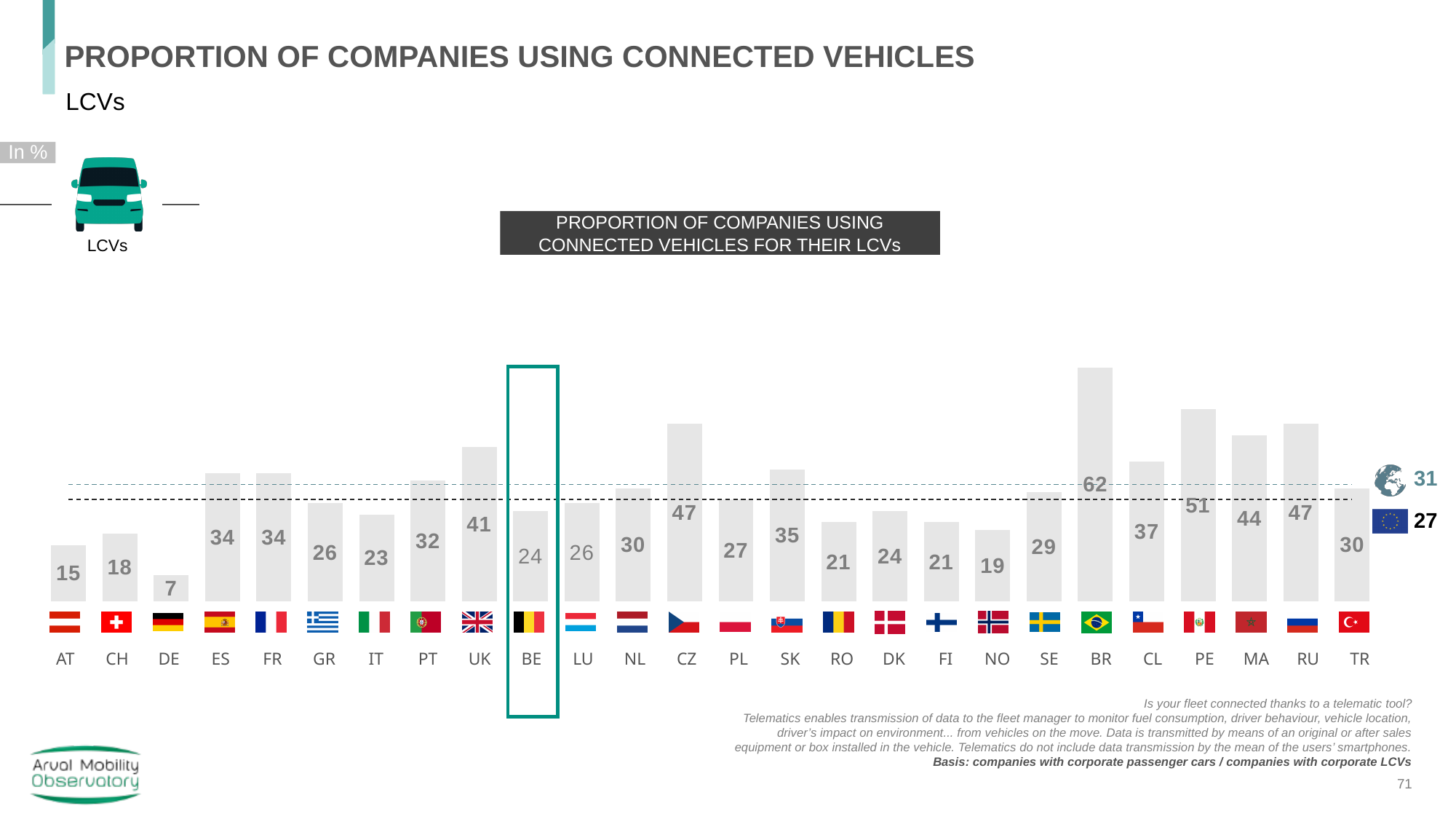
What is the value for BR (Brazil) in the chart? 62 What is the value for UK in the chart? 41 Which has a higher value, NO or SE? SE Which country has the highest proportion of companies using connected vehicles for their LCVs? BR Which has a higher value, CZ or SK? CZ What type of chart is used on this slide? Bar chart What is the difference between the values for PE and BE? 27 What is the difference between the values for BR and DE? 55 What is the value for BE (Belgium) in the chart? 24 Which country has the lowest proportion of companies using connected vehicles for their LCVs? DE What is the global average value shown next to the globe icon on the right of the chart? 31 How many countries are shown in the chart? 26